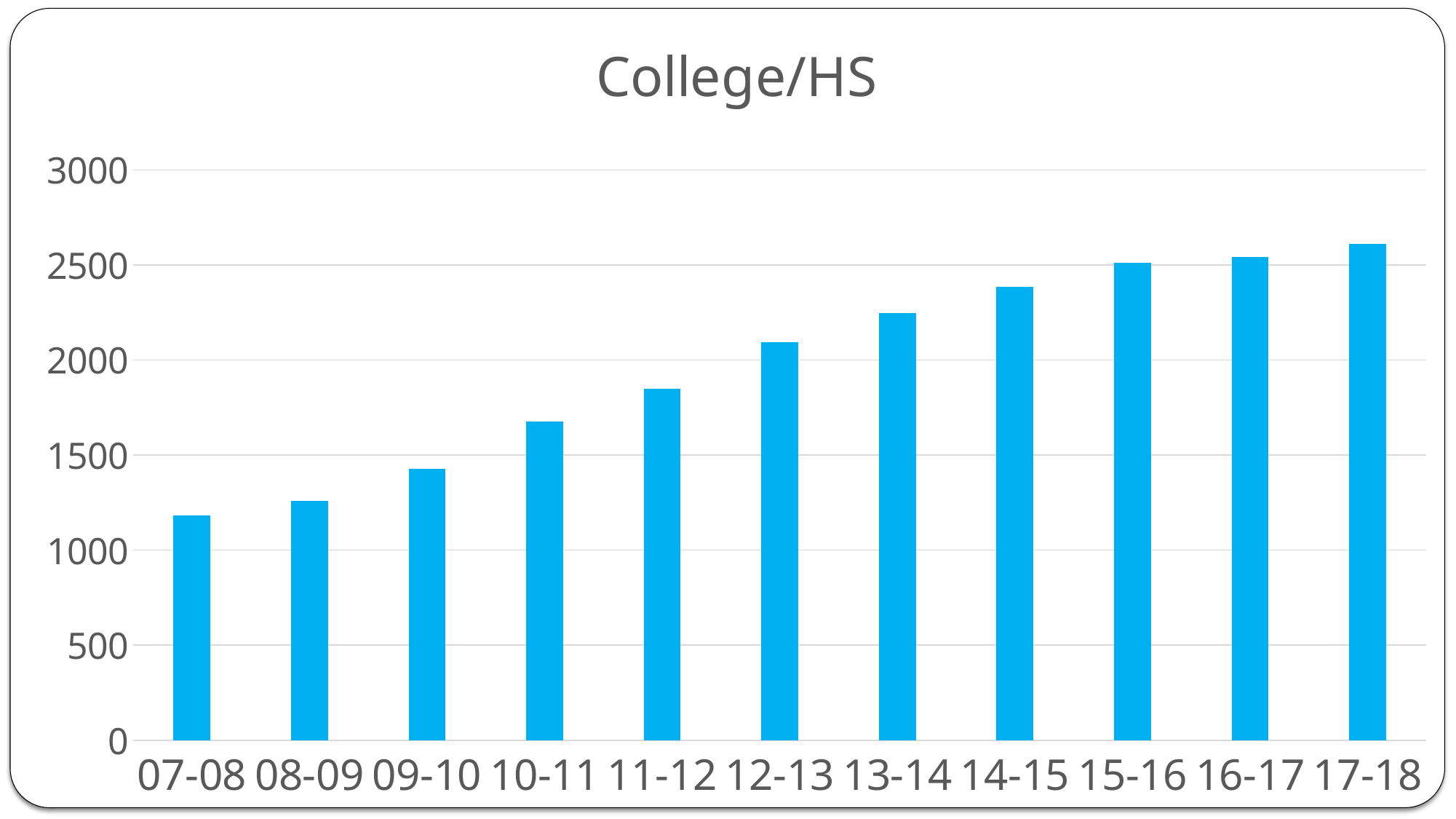
Which is larger, the value for 08-09 or the value for 11-12? 11-12 What is the title of the chart? College/HS Do the values rise or fall from 07-08 to 17-18? rise Which category has the highest value? 17-18 Is the value for 09-10 greater or less than 1500? less Which category has the lowest value? 07-08 How many categories are shown on the x axis? 11 Is the value for 12-13 greater or less than 2000? greater Is the value for 07-08 greater or less than 1000? greater What kind of chart is shown on the slide? bar chart Which is larger, the value for 10-11 or the value for 13-14? 13-14